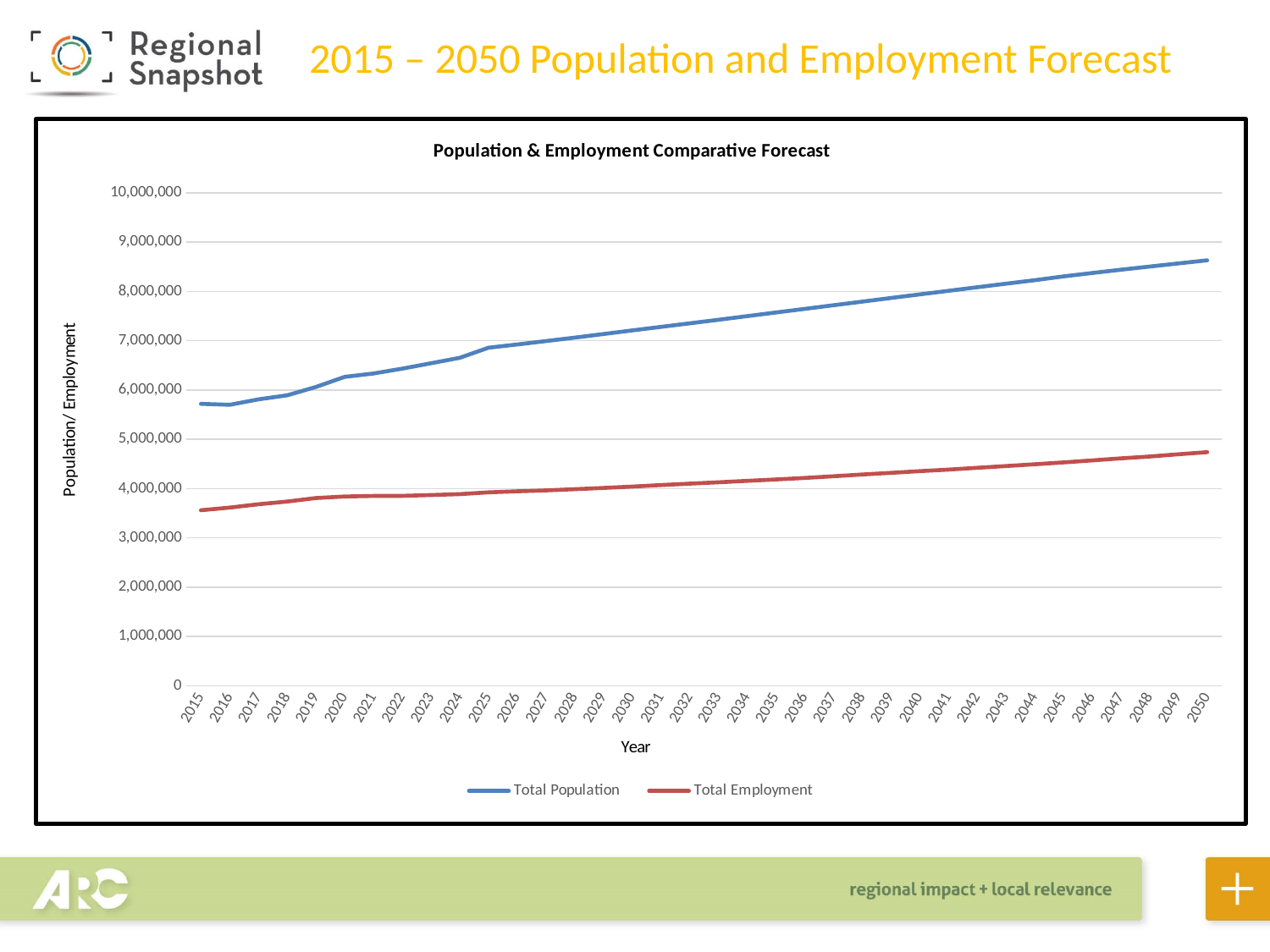
Does Total Population rise or fall from 2015 to 2050? Rise Is the Total Population value for 2050 greater or less than 8,000,000? greater Is the Total Employment value for 2050 greater or less than 5,000,000? less In which year is Total Employment lowest? 2015 In 2030, which is larger, Total Population or Total Employment? Total Population Does Total Employment rise or fall from 2015 to 2050? Rise How many years are plotted along the x axis? 36 What kind of chart is shown on the slide? Line chart Is the Total Employment value for 2015 greater or less than 4,000,000? less How many series does the legend list? 2 What is the title of the chart? Population & Employment Comparative Forecast